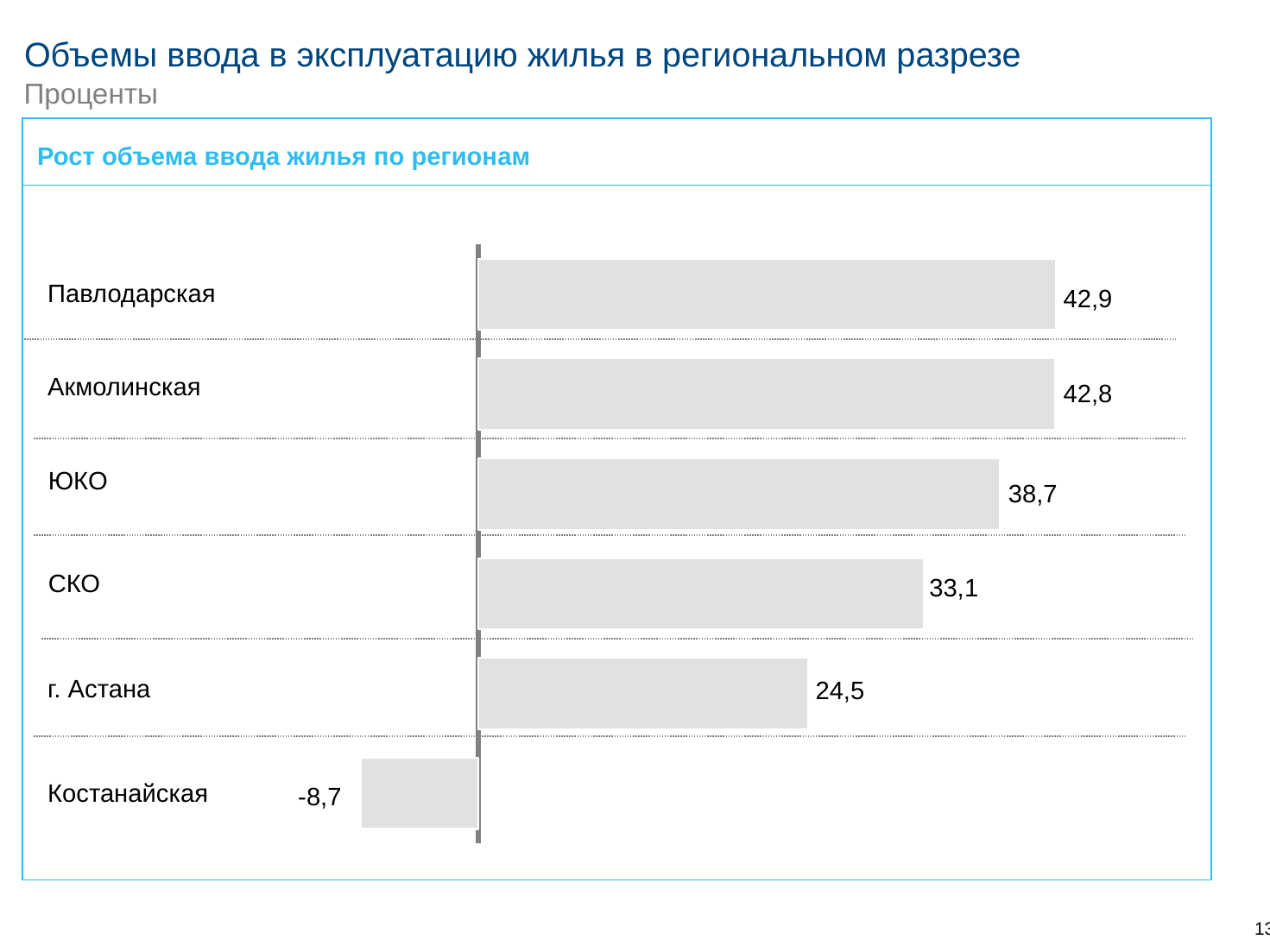
Which is larger, the value for ЮКО or the value for СКО? ЮКО What is the value for ЮКО? 38,7 What is the title of the chart? Рост объема ввода жилья по регионам What is the value for Павлодарская? 42,9 What is the value for г. Астана? 24,5 What is the difference between the values for ЮКО and СКО? 5,6 Which region has the lowest value? Костанайская What is the value for Костанайская? -8,7 What is the difference between the values for Павлодарская and г. Астана? 18,4 What is the value for Акмолинская? 42,8 How many regions are shown in the chart? 6 What kind of chart is shown on the slide? Bar chart